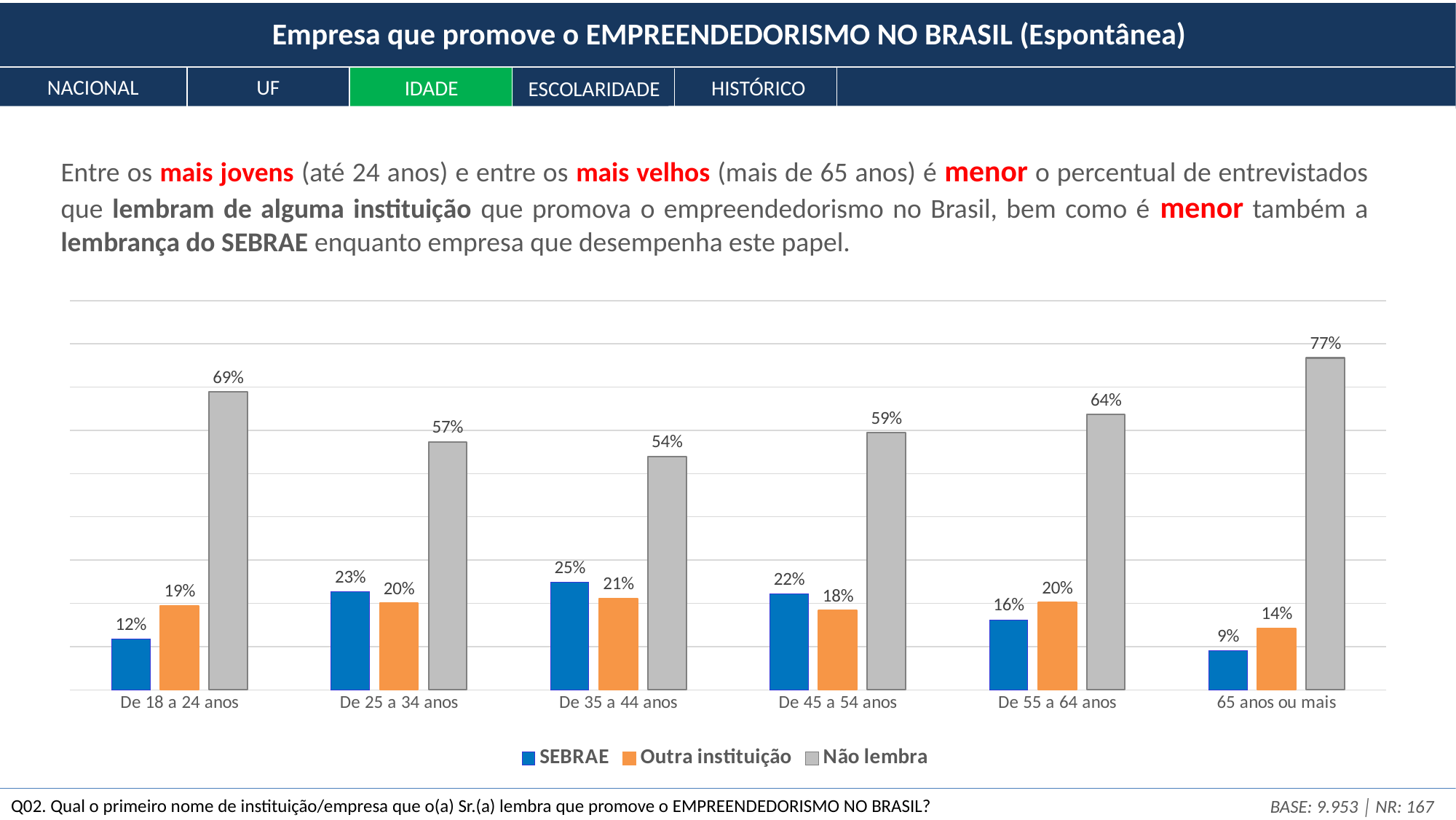
Which series is shown in orange in the legend? Outra instituição What is the SEBRAE value for the 'De 35 a 44 anos' age group? 25% What is the difference between the SEBRAE and 'Outra instituição' values for 'De 18 a 24 anos'? 7% What is the difference between the 'Não lembra' values for 'De 18 a 24 anos' and 'De 25 a 34 anos'? 12% Which is larger: the SEBRAE value for 'De 25 a 34 anos' or for 'De 55 a 64 anos'? De 25 a 34 anos Which age group has the highest 'Não lembra' value? 65 anos ou mais What is the 'Não lembra' value for the '65 anos ou mais' age group? 77% How many age groups are shown on the x axis? 6 What is the 'Outra instituição' value for the 'De 45 a 54 anos' age group? 18% How many series does the legend list? 3 What kind of chart is shown on the slide? Bar chart Which age group has the lowest SEBRAE value? 65 anos ou mais